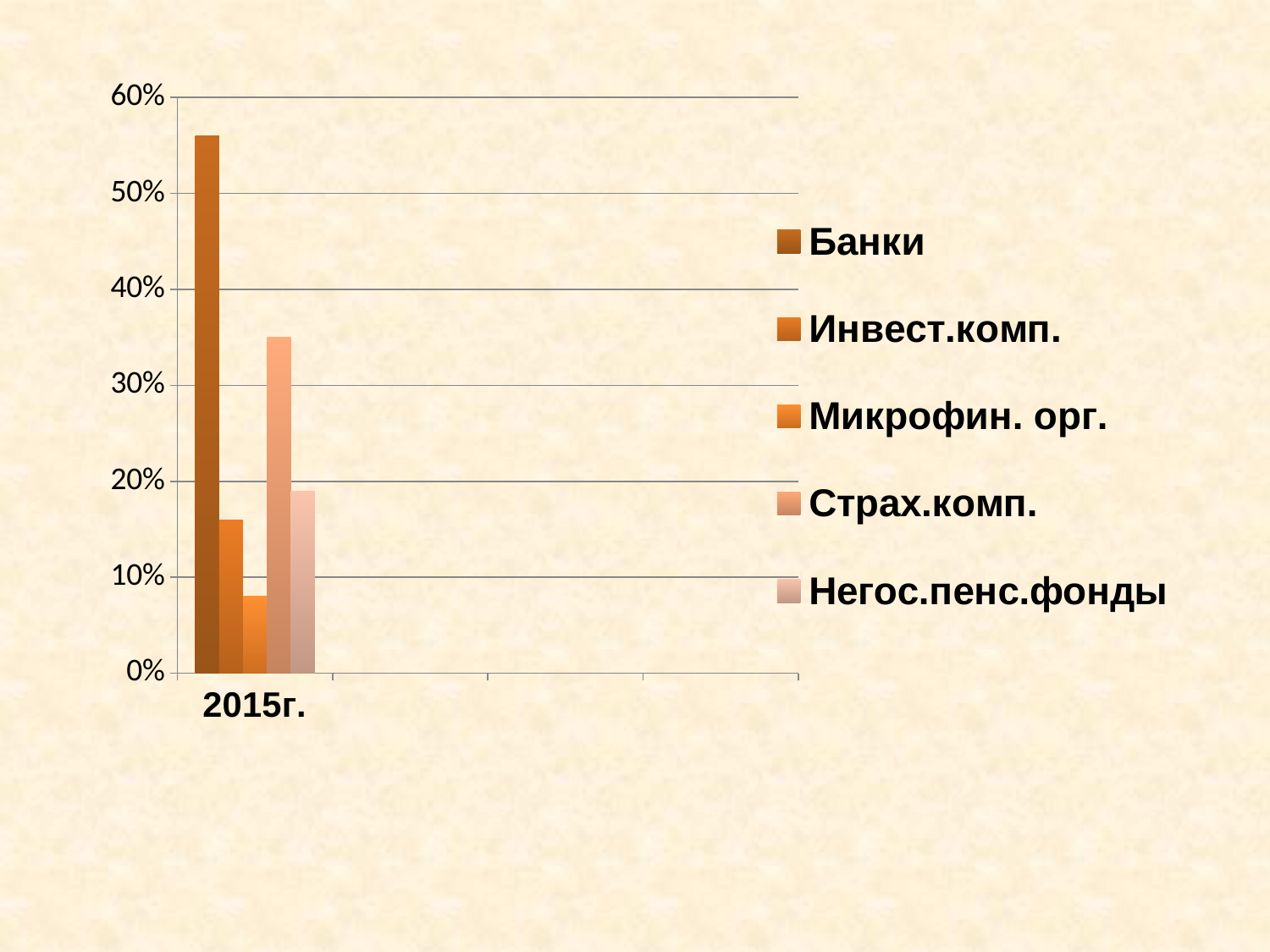
Which series has the lowest value for 2015г.? Микрофин. орг. Is the value for Микрофин. орг. in 2015г. greater or less than 10%? less What is the label of the category on the x axis? 2015г. Is the value for Банки in 2015г. greater or less than 50%? greater What kind of chart is shown on the slide? bar chart Which series has the highest value for 2015г.? Банки Which is larger in 2015г., Страх.комп. or Инвест.комп.? Страх.комп. Is the value for Страх.комп. in 2015г. greater or less than 30%? greater How many categories are shown on the x axis? 1 How many series does the legend list? 5